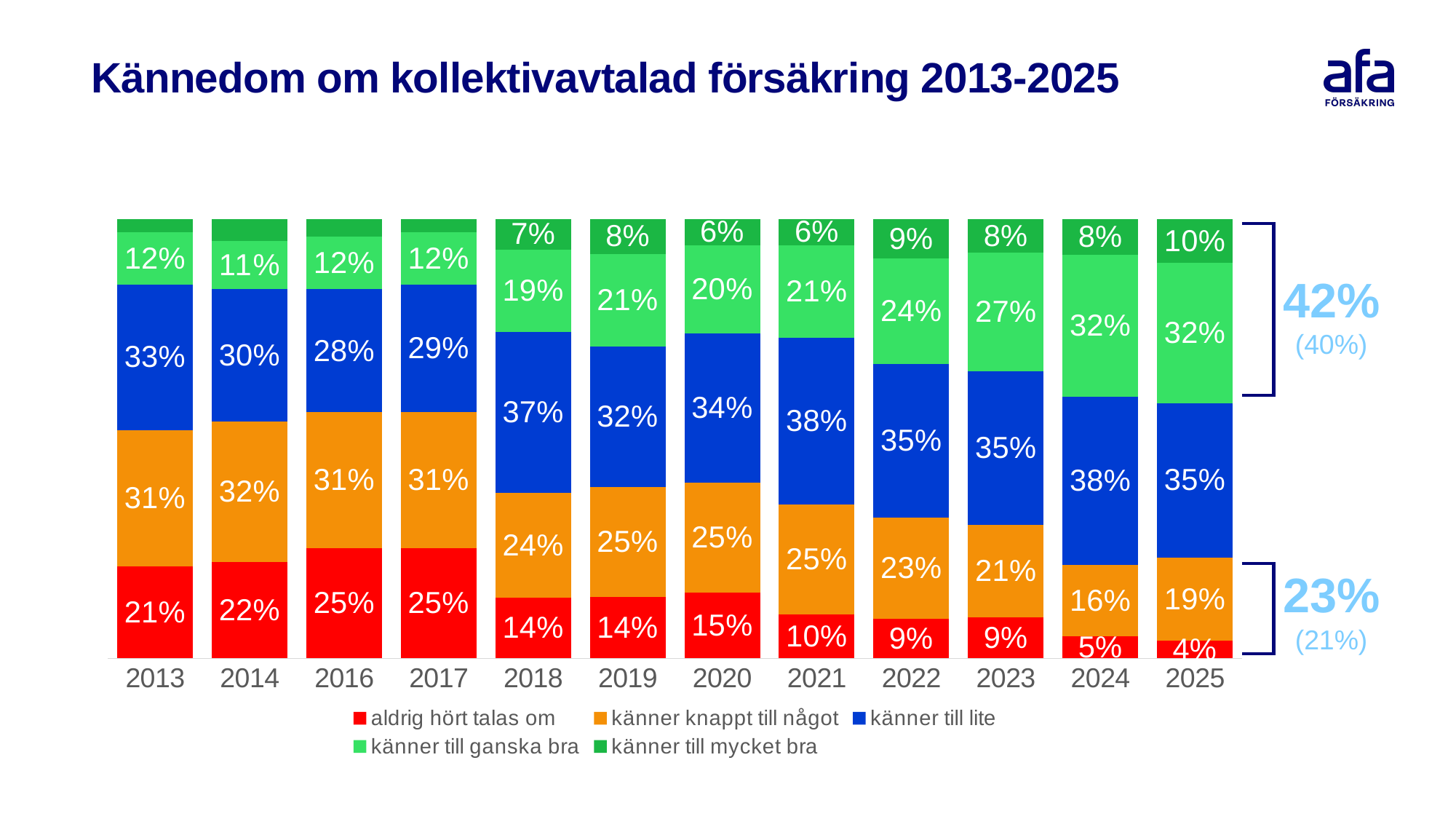
What kind of chart is shown on the slide? Stacked bar chart How many years are shown on the x axis? 12 Which year has the larger "känner till lite" share, 2018 or 2019? 2018 By how many percentage points did "aldrig hört talas om" fall from 2013 to 2025? 17 percentage points What percentage answered "känner till ganska bra" in 2024? 32% In which year is the "aldrig hört talas om" share lowest? 2025 How many series does the legend list? 5 Does the "aldrig hört talas om" share rise or fall from 2018 to 2025? Fall What is the value for "känner knappt till något" in 2013? 31% What percentage answered "aldrig hört talas om" in 2025? 4% In which year is the "känner knappt till något" share lowest? 2024 What is the value for "känner till lite" in 2018? 37%